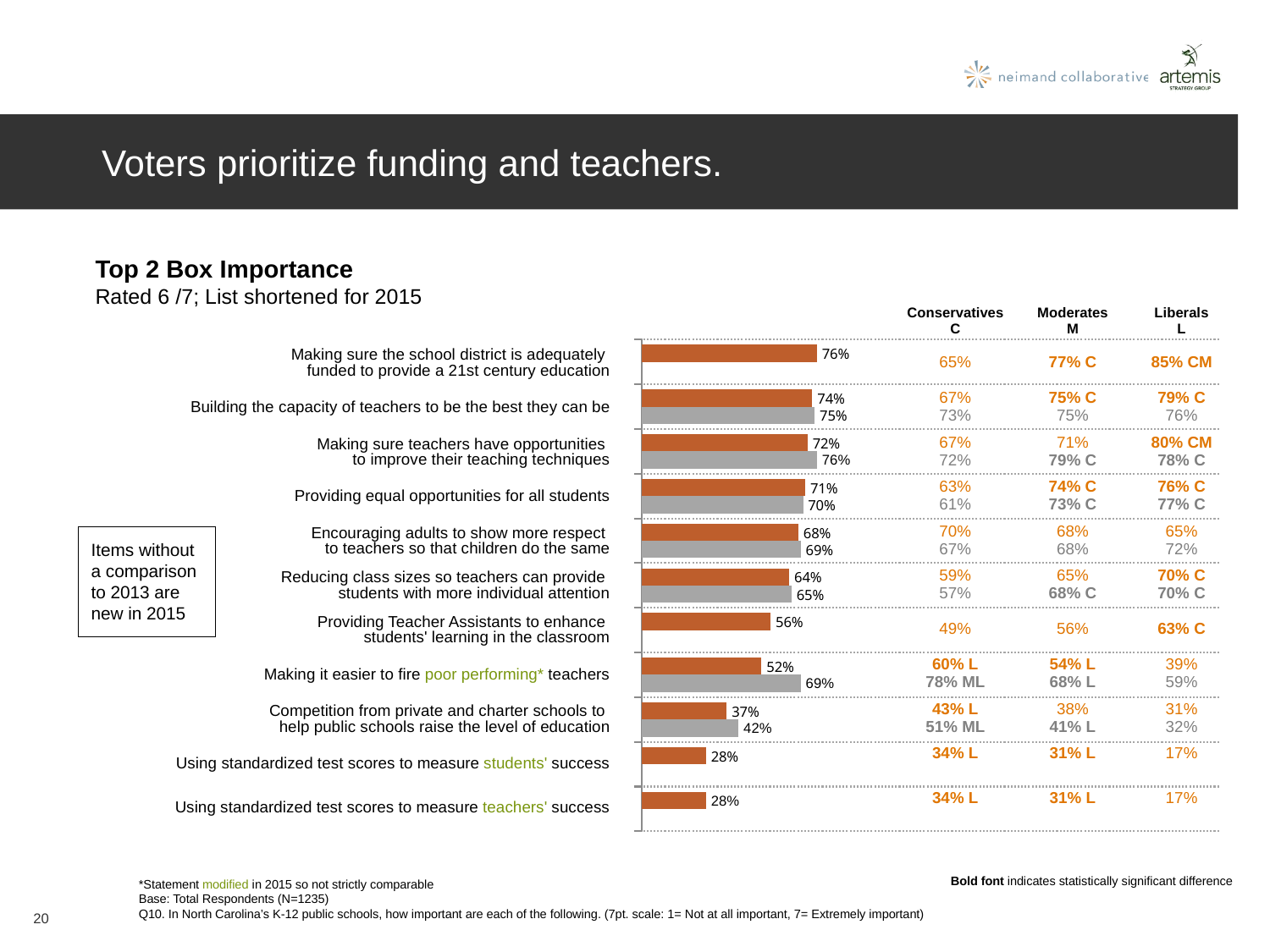
What is the value of the orange bar for "Providing Teacher Assistants to enhance students' learning in the classroom"? 56% How many items are listed in the bar chart? 11 What kind of chart is shown on the slide? bar chart What is the difference between the orange bar values for "Building the capacity of teachers to be the best they can be" and "Reducing class sizes so teachers can provide students with more individual attention"? 10% Which item has the highest orange bar value? Making sure the school district is adequately funded to provide a 21st century education What is the difference between the gray bar and the orange bar for "Making it easier to fire poor performing* teachers"? 17% Which item has the lowest gray bar value? Competition from private and charter schools to help public schools raise the level of education For "Making sure teachers have opportunities to improve their teaching techniques", which bar is larger, the orange or the gray? gray Is the orange bar value for "Using standardized test scores to measure students' success" greater or less than 50%? less What two colours are used for the bars in the chart? orange and gray What is the value of the orange bar for "Making sure the school district is adequately funded to provide a 21st century education"? 76% What is the value of the gray bar for "Making it easier to fire poor performing* teachers"? 69%